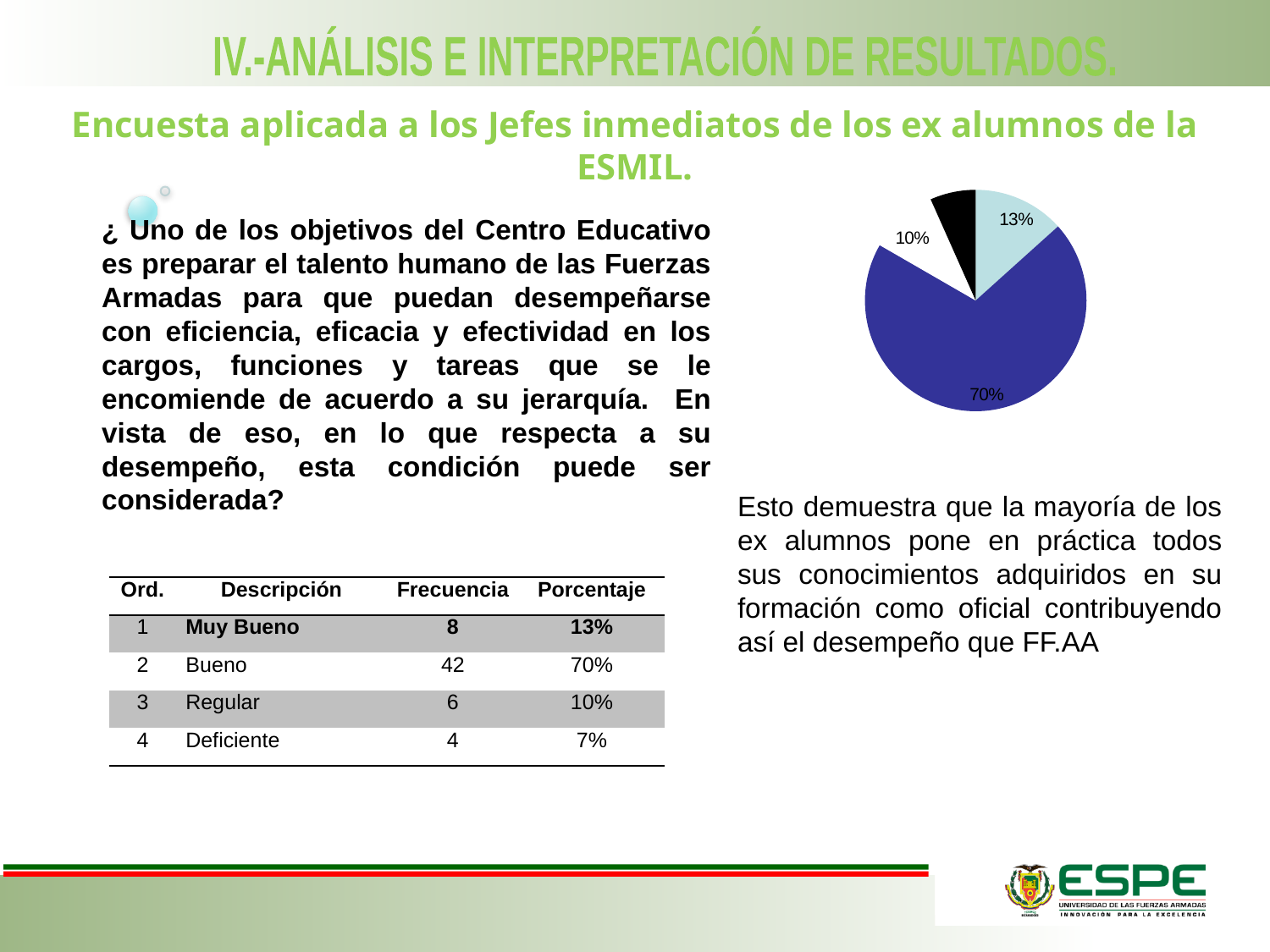
What colour is the largest slice of the pie chart? dark blue How many percentage labels are printed on the pie chart? 3 What is the difference between the 70% slice and the 13% slice in the pie chart? 57 percentage points What is the value of the largest slice in the pie chart? 70% Which is larger in the pie chart, the slice labelled 13% or the slice labelled 10%? 13% What is the smallest percentage label printed on the pie chart? 10% What is the difference between the 13% slice and the 10% slice in the pie chart? 3 percentage points Is the largest slice of the pie chart greater or less than 50%? greater What percentage is shown on the dark blue slice of the pie chart? 70% What percentage is shown on the light blue slice of the pie chart? 13% What kind of chart is shown on the slide? pie chart According to the table on the slide, what share of the pie corresponds to 'Bueno'? 70%